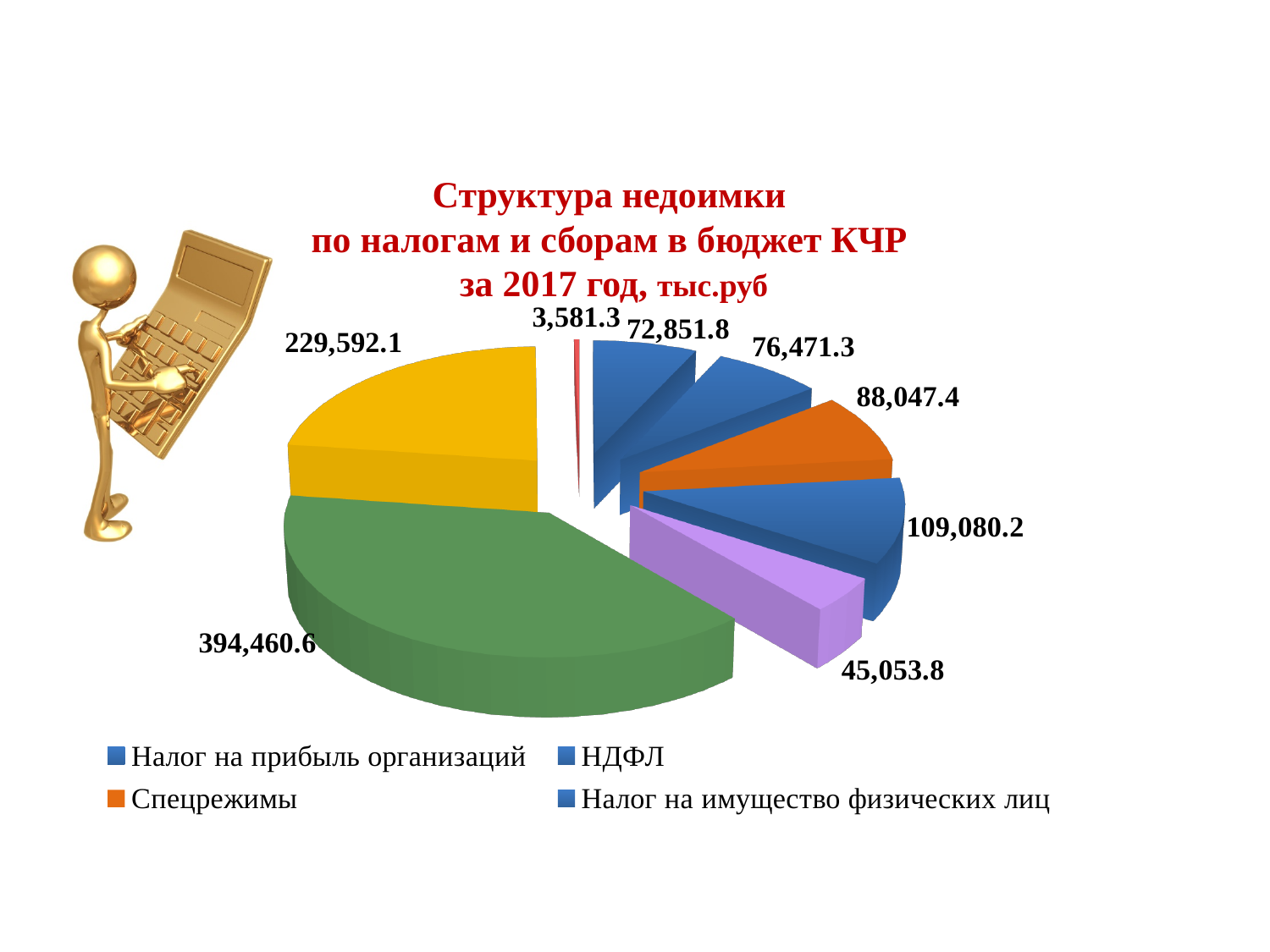
Which is larger, the green slice or the yellow slice? the green slice What is the value of the orange slice (Спецрежимы)? 88,047.4 What is the value of the yellow slice? 229,592.1 What is the smallest value shown on the pie chart? 3,581.3 For which year does the chart show the structure of tax arrears? 2017 How many entries does the legend list? 4 How many slices does the pie chart have? 8 What is the difference between the green slice (394,460.6) and the yellow slice (229,592.1)? 164,868.5 What kind of chart is shown on the slide? pie chart What is the largest value shown on the pie chart? 394,460.6 What is the value of the purple slice? 45,053.8 What is the difference between the slices labelled 109,080.2 and 45,053.8? 64,026.4